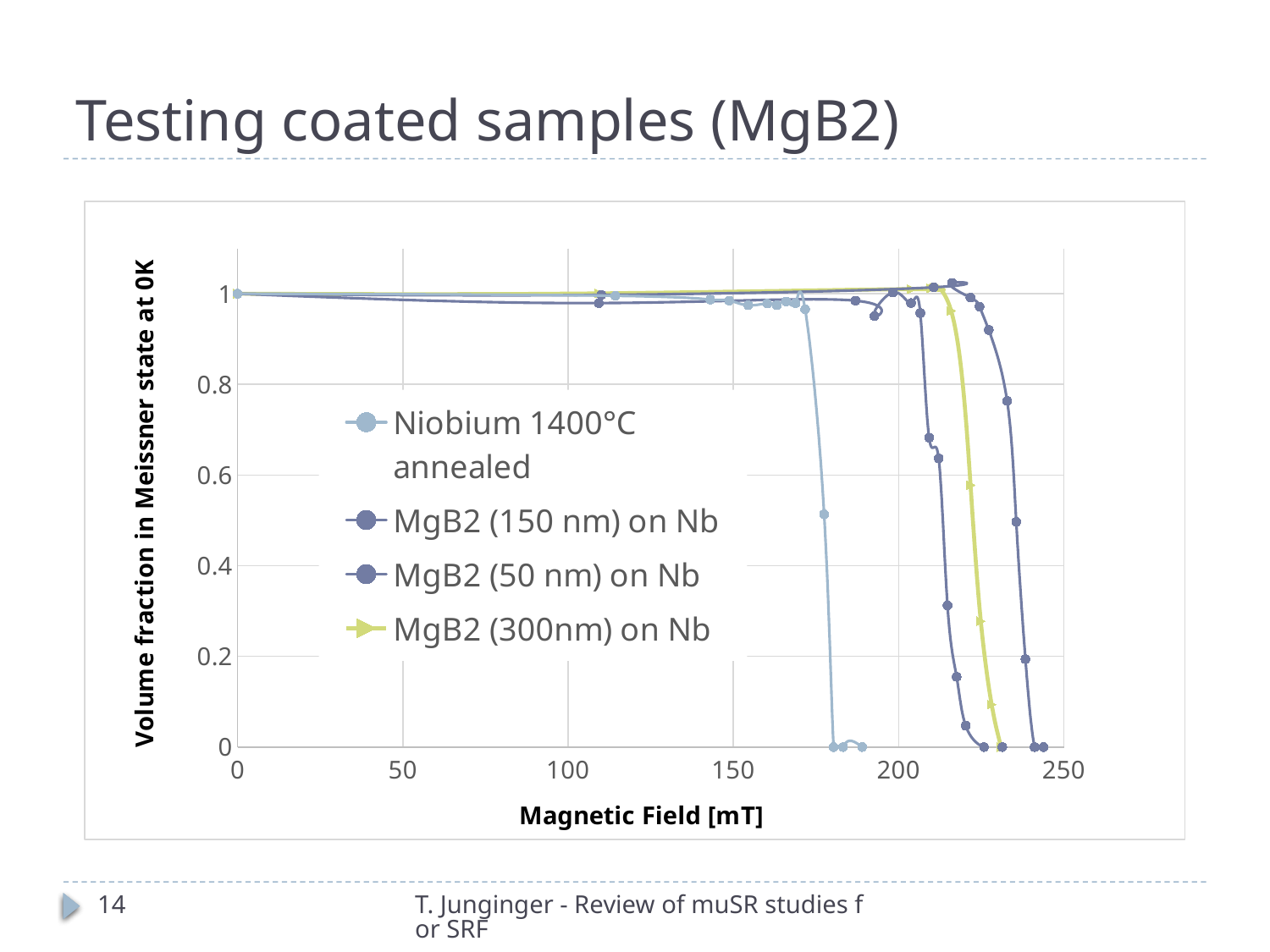
Is the value for Niobium 1400°C annealed at 190 mT greater or less than 0.2? less Is the value for Niobium 1400°C annealed at 100 mT greater or less than 0.8? greater What is the title of the x axis? Magnetic Field [mT] Is the value for MgB2 (300nm) on Nb at 230 mT greater or less than 0.2? less How many series does the legend list? 4 What is the title of the y axis? Volume fraction in Meissner state at 0K Which series loses its Meissner state (drops to 0) at the lowest magnetic field? Niobium 1400°C annealed What kind of chart is shown on the slide? line chart At 150 mT, which series has the larger value: Niobium 1400°C annealed or MgB2 (300nm) on Nb? MgB2 (300nm) on Nb Do the plotted values rise or fall as the magnetic field increases toward 250 mT? fall What is the highest value shown on the x axis? 250